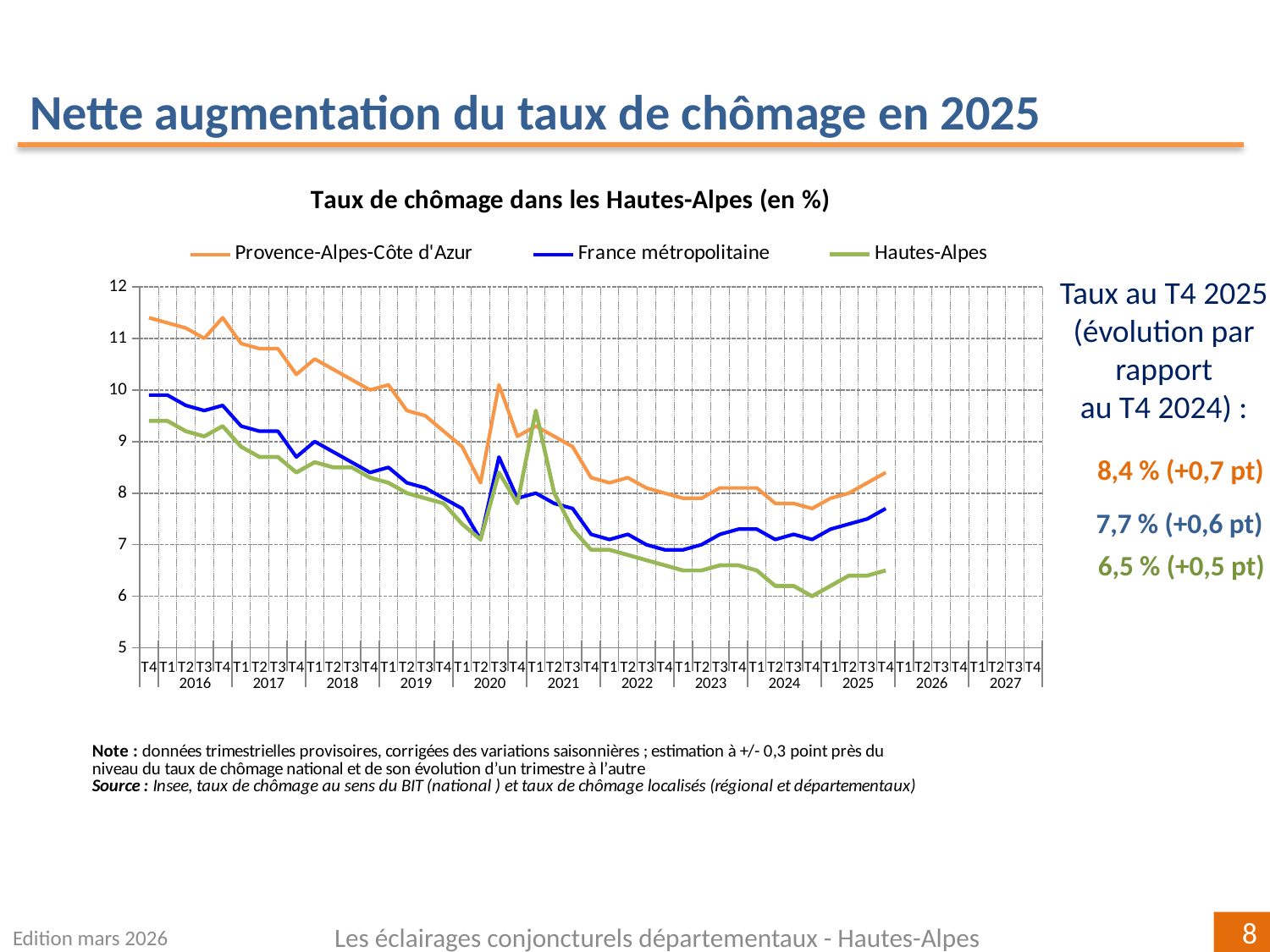
Does the Hautes-Alpes unemployment rate rise or fall between 2016 and 2019? fall What is the title of the chart? Taux de chômage dans les Hautes-Alpes (en %) What is the unemployment rate for Provence-Alpes-Côte d'Azur at T4 2025? 8,4 % What is the unemployment rate for France métropolitaine at T4 2025? 7,7 % How many series does the legend list? 3 At T4 2025, which series has the highest unemployment rate? Provence-Alpes-Côte d'Azur What is the difference between the Provence-Alpes-Côte d'Azur rate and the Hautes-Alpes rate at T4 2025? 1,9 points What kind of chart is shown on the slide? line chart By how many points did the Hautes-Alpes rate change between T4 2024 and T4 2025? +0,5 pt Is the value for Hautes-Alpes at T4 2024 greater or less than 7? less What is the unemployment rate for Hautes-Alpes at T4 2025? 6,5 % At T4 2025, which series has the lowest unemployment rate? Hautes-Alpes